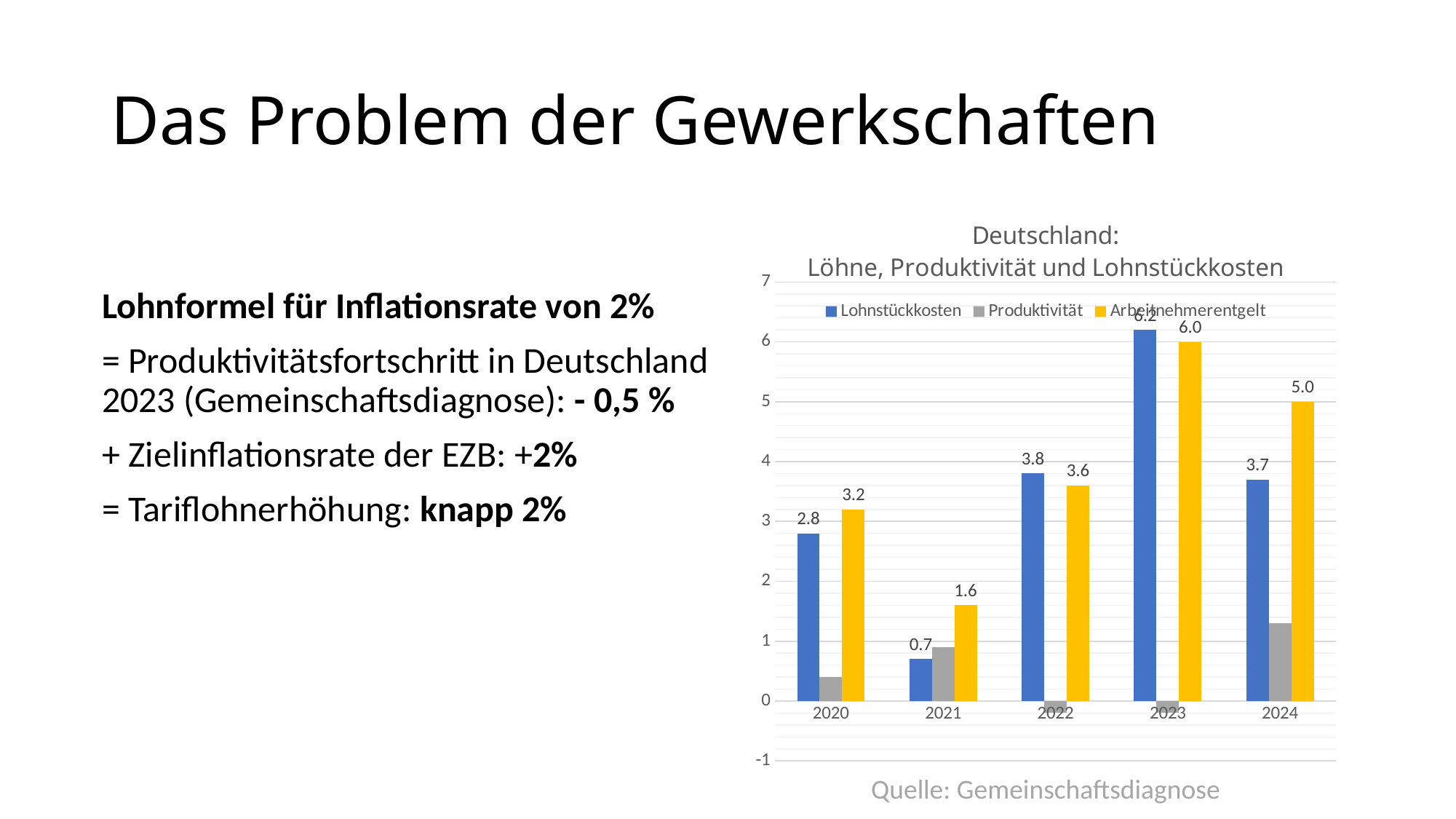
What is the difference between Arbeitnehmerentgelt and Lohnstückkosten in 2024? 1.3 What is the value of Lohnstückkosten for 2023? 6.2 In 2022, which is larger: Lohnstückkosten or Arbeitnehmerentgelt? Lohnstückkosten What is the value of Lohnstückkosten for 2021? 0.7 In which year is Lohnstückkosten highest? 2023 How many years are shown on the x axis of the chart? 5 Is the value for Produktivität in 2024 greater or less than 1? greater What is the value of Arbeitnehmerentgelt for 2024? 5.0 Does Arbeitnehmerentgelt rise or fall from 2021 to 2023? rise What kind of chart is shown on the slide? bar chart In which year is Arbeitnehmerentgelt lowest? 2021 How many series does the chart legend list? 3